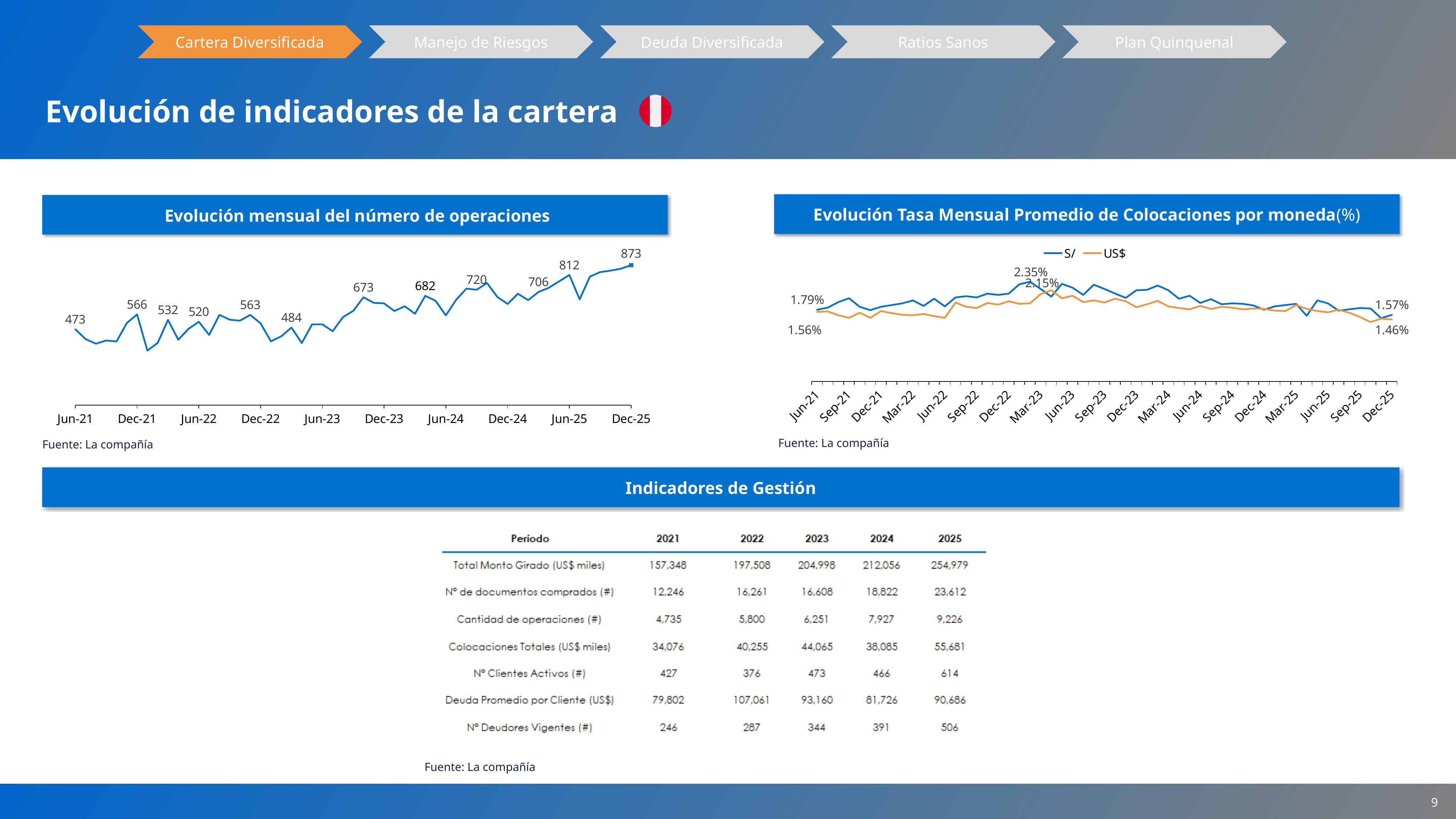
What are the two legend entries in the 'Evolución Tasa Mensual Promedio de Colocaciones por moneda(%)' chart? S/ and US$ How many series does the legend of the 'Evolución Tasa Mensual Promedio de Colocaciones por moneda(%)' chart list? 2 In the 'Evolución Tasa Mensual Promedio de Colocaciones por moneda(%)' chart, what is the difference between the S/ and US$ values at Dec-25? 0.11% In the 'Evolución mensual del número de operaciones' chart, what is the value for Dec-25? 873 In the 'Evolución mensual del número de operaciones' chart, what is the highest labelled value? 873 In the 'Evolución Tasa Mensual Promedio de Colocaciones por moneda(%)' chart, what is the S/ value at Dec-25? 1.57% In the 'Evolución Tasa Mensual Promedio de Colocaciones por moneda(%)' chart, which series has the higher value at Dec-25, S/ or US$? S/ In the 'Evolución mensual del número de operaciones' chart, what is the difference between the Dec-25 value and the Jun-21 value? 400 In the 'Evolución mensual del número de operaciones' chart, what is the value for Jun-21? 473 What kind of chart is the 'Evolución mensual del número de operaciones' chart? line chart In the 'Evolución mensual del número de operaciones' chart, do the values generally rise or fall from Jun-21 to Dec-25? rise In the 'Evolución Tasa Mensual Promedio de Colocaciones por moneda(%)' chart, what is the US$ value at Jun-21? 1.56%